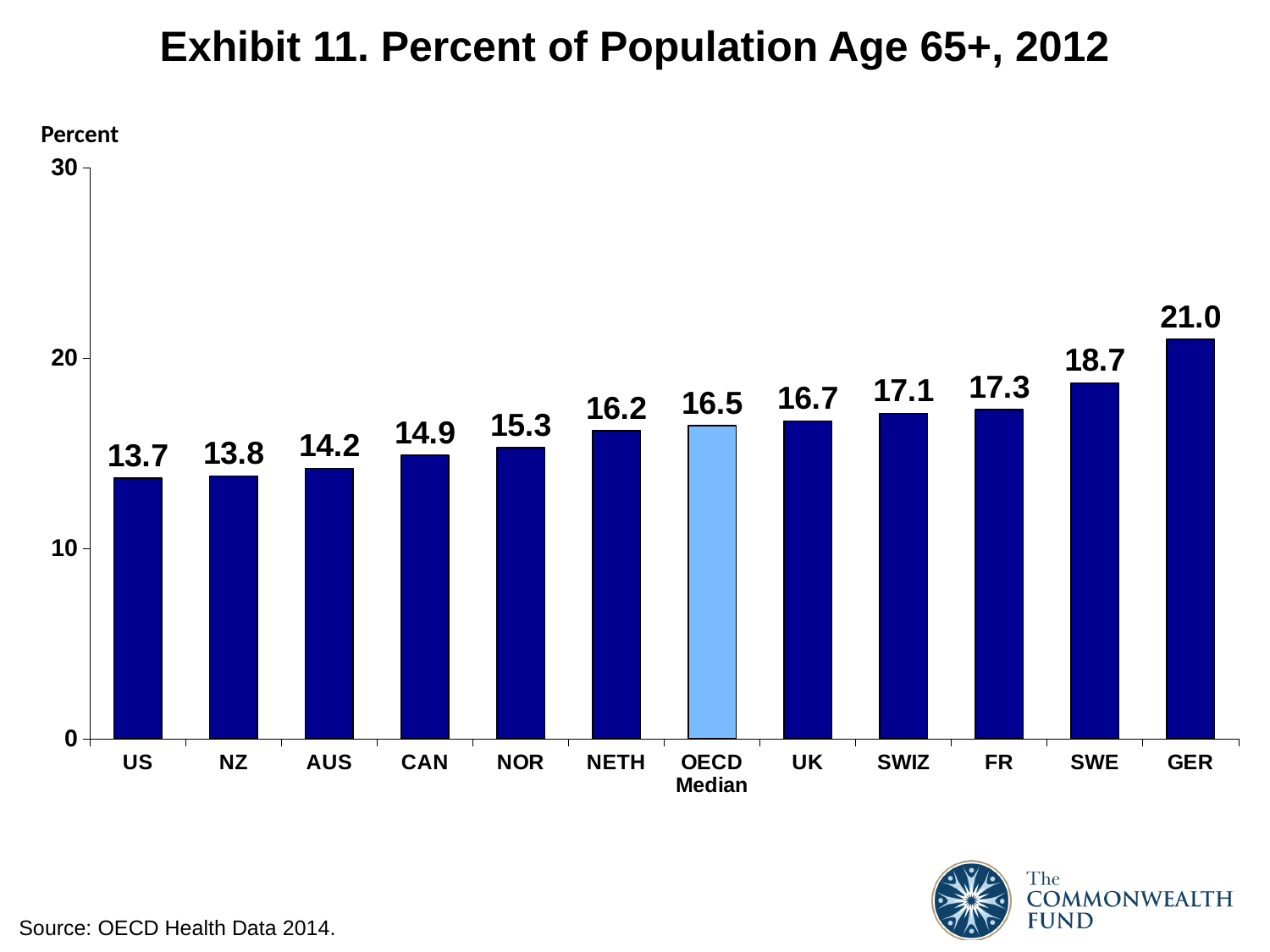
What is the value shown for the OECD Median? 16.5 Which country has the lowest percent of population age 65+? US Is the value for GER greater or less than 20? greater What is the value shown for SWE? 18.7 What kind of chart is shown on the slide? bar chart Which has a larger value, FR or NOR? FR Which country has the highest percent of population age 65+? GER How many bars are shown in the chart? 12 What is the difference between the values for GER and US? 7.3 What is the percent of population age 65+ for the US? 13.7 What is the difference between the values for UK and CAN? 1.8 Which bar is shown in a lighter blue colour than the others? OECD Median